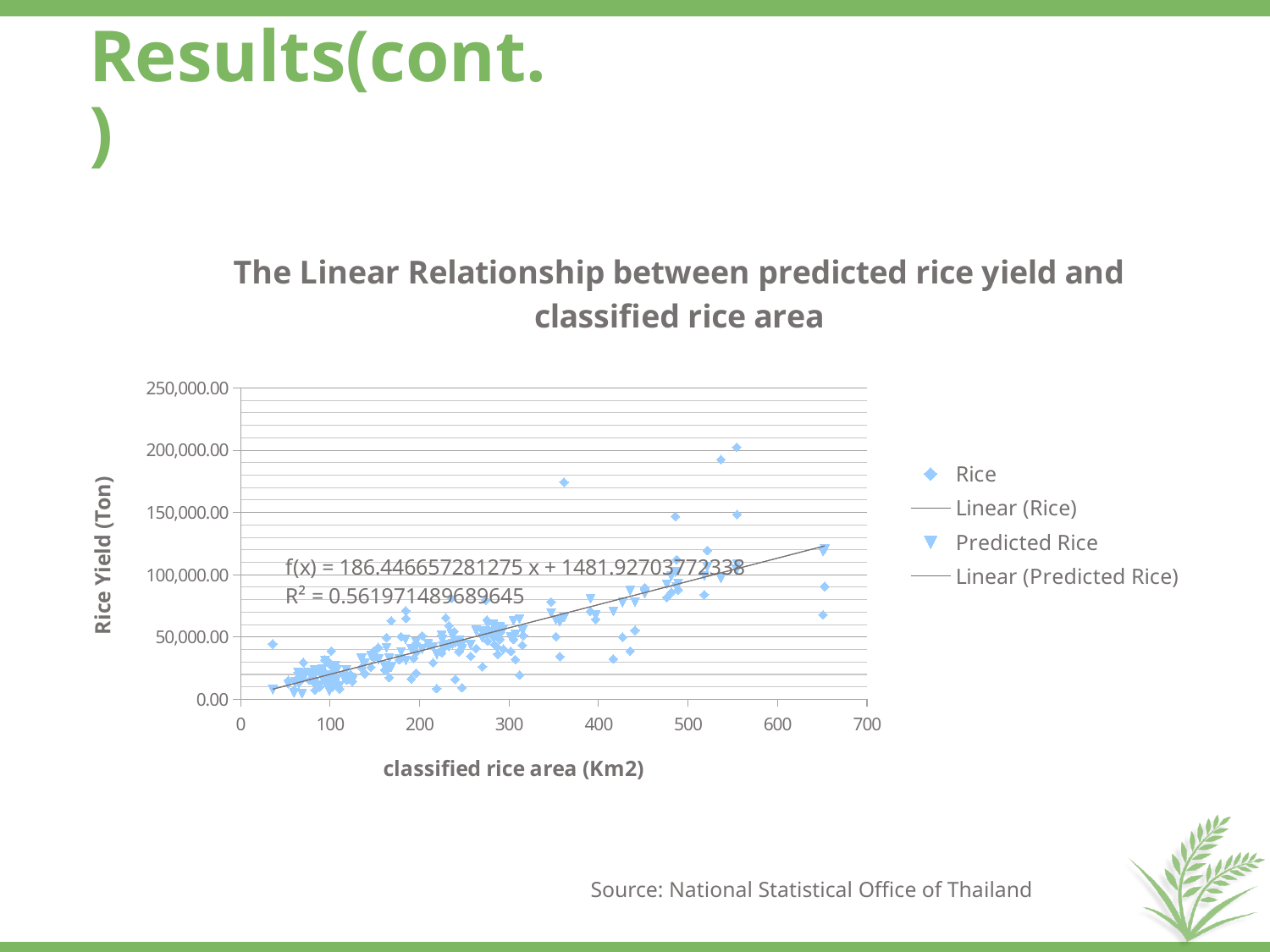
What kind of chart is shown on the slide? Scatter chart What is the slope of the trendline equation printed on the chart? 186.446657281275 How many entries does the chart legend list? 4 What is the intercept of the trendline equation printed on the chart? 1481.92703772338 Is the lowest plotted Rice Yield value greater or less than 50,000.00? less Do the rice yield values generally rise or fall as the classified rice area increases? Rise What are the four entries listed in the chart legend? Rice, Linear (Rice), Predicted Rice, Linear (Predicted Rice) What is the R² value printed on the chart? 0.561971489689645 Is the highest plotted Rice Yield value greater or less than 150,000.00? greater What is the title of the chart? The Linear Relationship between predicted rice yield and classified rice area